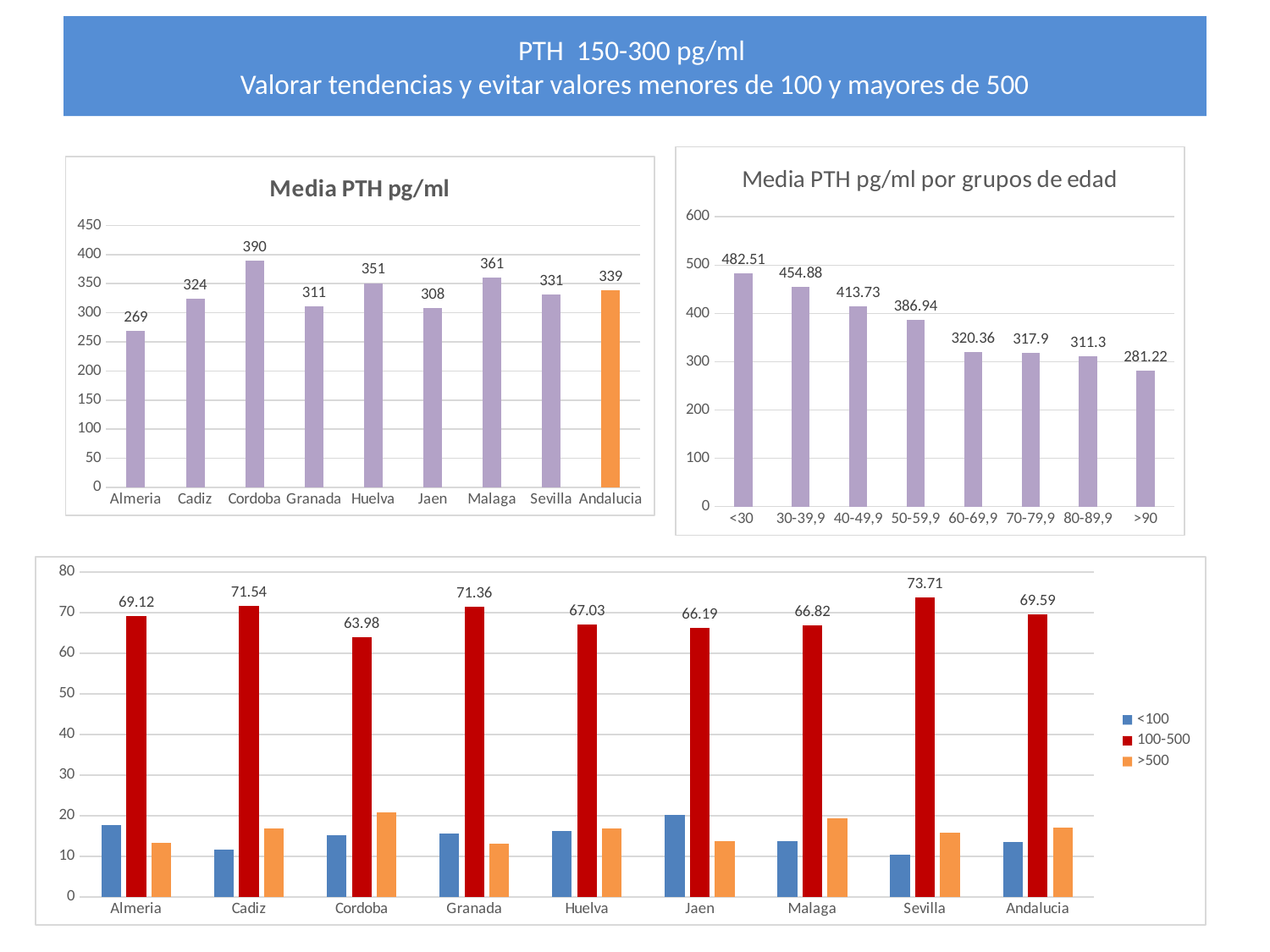
In the 'Media PTH pg/ml por grupos de edad' chart, which age group has the highest value? <30 In the bottom chart, is the <100 value for Jaen greater or less than 10? greater In the 'Media PTH pg/ml por grupos de edad' chart, which is larger, the value for 60-69,9 or 80-89,9? 60-69,9 In the bottom chart, what is the 100-500 value for Sevilla? 73.71 What kind of chart is the bottom chart? bar chart In the 'Media PTH pg/ml' chart, which category has the lowest value? Almeria In the 'Media PTH pg/ml por grupos de edad' chart, do the values rise or fall as age increases along the x axis? fall In the 'Media PTH pg/ml' chart, how many categories are shown on the x axis? 9 In the 'Media PTH pg/ml' chart, what is the difference between Malaga and Jaen? 53 In the 'Media PTH pg/ml por grupos de edad' chart, what is the value for the 50-59,9 group? 386.94 In the 'Media PTH pg/ml' chart, what is the value for Cordoba? 390 In the bottom chart, how many series does the legend list? 3